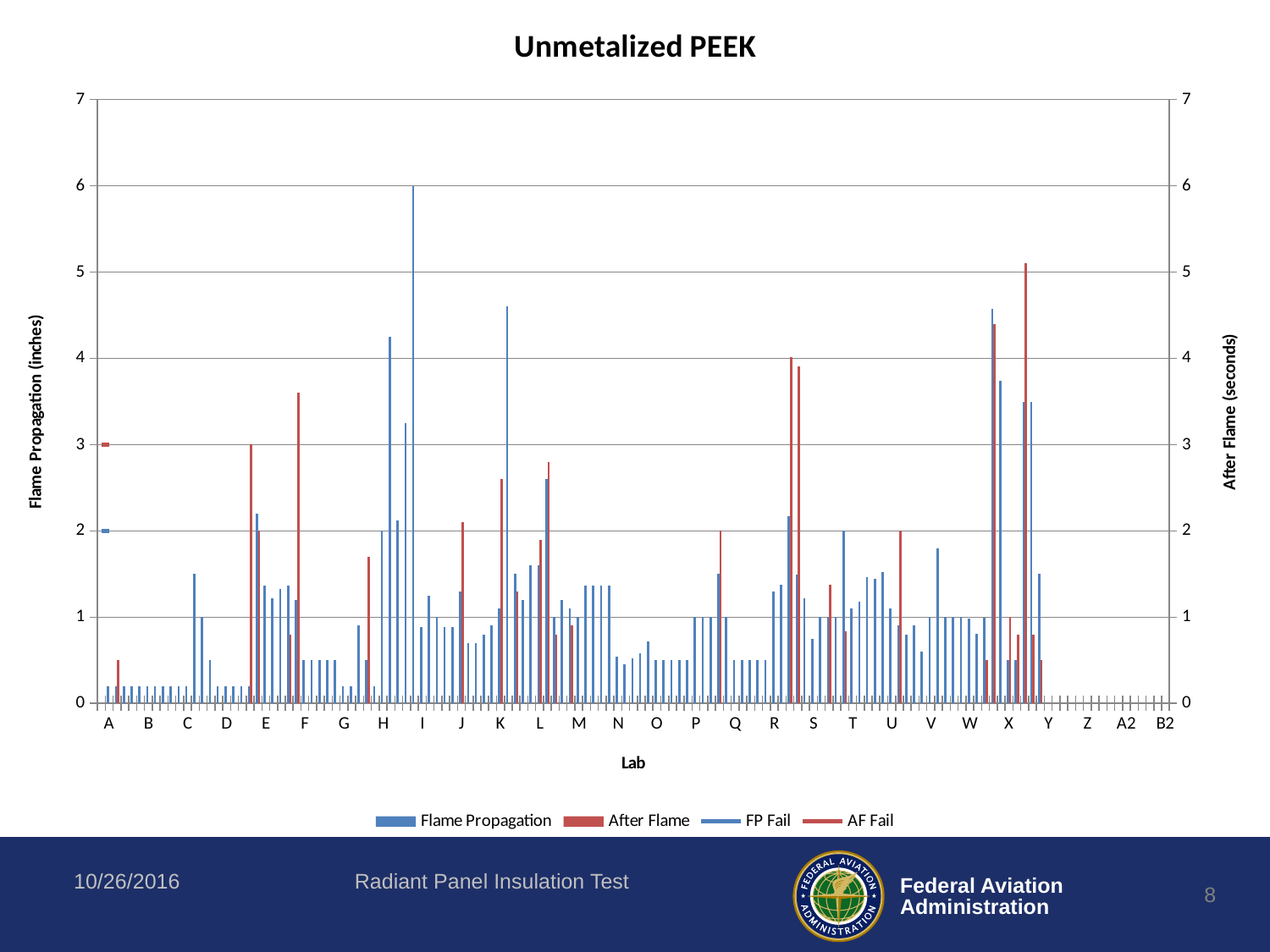
Is the tallest After Flame bar greater or less than 4 seconds? greater Near which lab label does the tallest Flame Propagation bar appear? I Is the tallest bar near lab F greater or less than 3? greater Which series has the tallest bar on the chart, Flame Propagation or After Flame? Flame Propagation How many entries does the chart legend list? 4 What value does the tallest Flame Propagation bar reach on the left axis? 6 Do labs Z, A2 and B2 show any bars greater than 1? No What is the title of the chart? Unmetalized PEEK How many lab categories are labeled along the x axis? 28 What kind of chart is shown on the slide? bar chart What is the label of the x axis? Lab